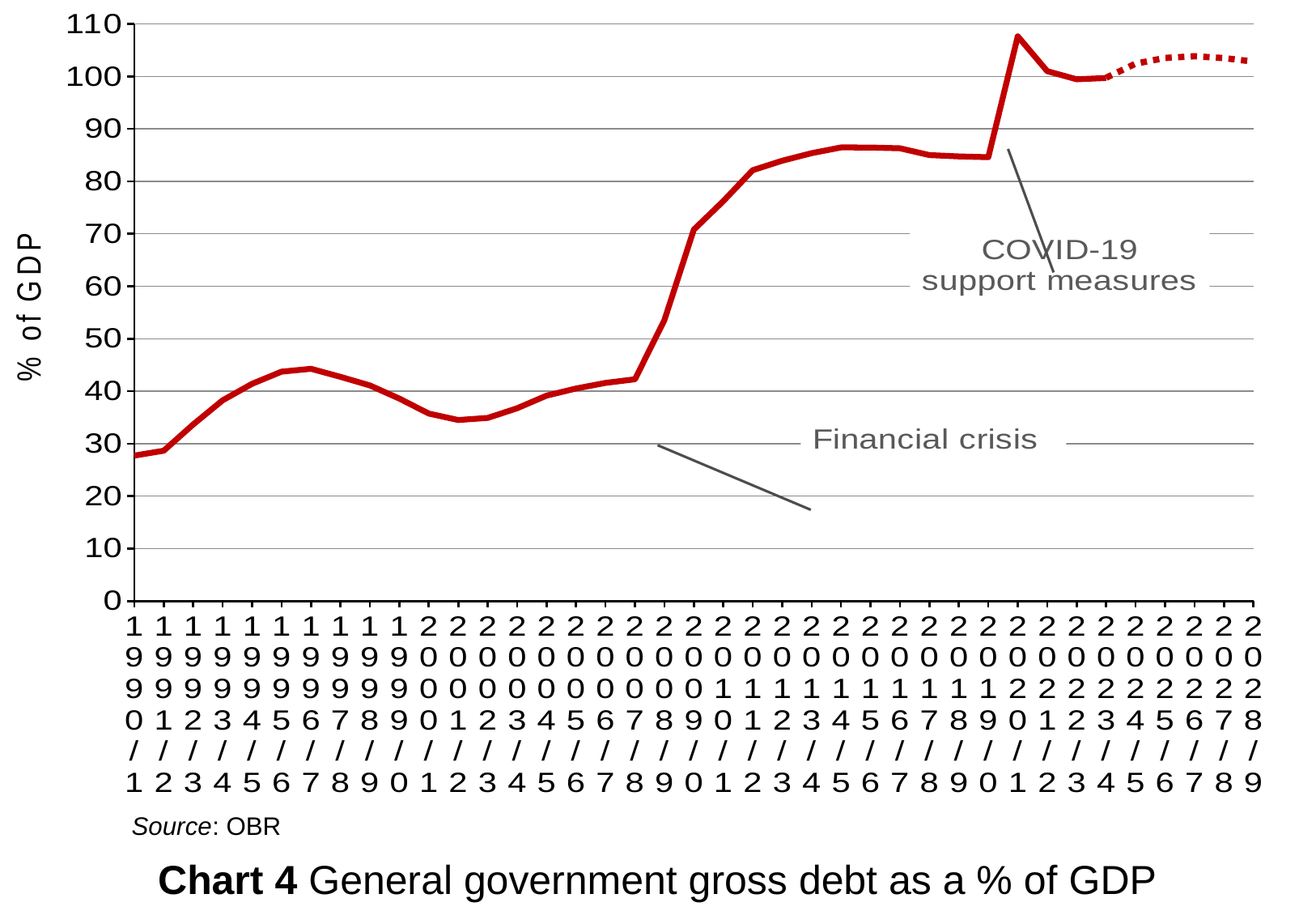
What is the source given for the chart? OBR Which fiscal year has the larger value, 1996/7 or 2001/2? 1996/7 In which fiscal year does general government gross debt reach its highest value? 2020/1 In which fiscal year is general government gross debt at its lowest value? 1990/1 Is the value for 2009/10 greater or less than 60? greater What kind of chart is shown on the slide? Line chart Is the value for 2007/8 greater or less than 50? less Do the values rise or fall between 2007/8 and 2010/11? Rise How many fiscal years are plotted along the x axis? 39 Is the value for 2001/2 greater or less than 40? less What is the title of the chart? Chart 4 General government gross debt as a % of GDP